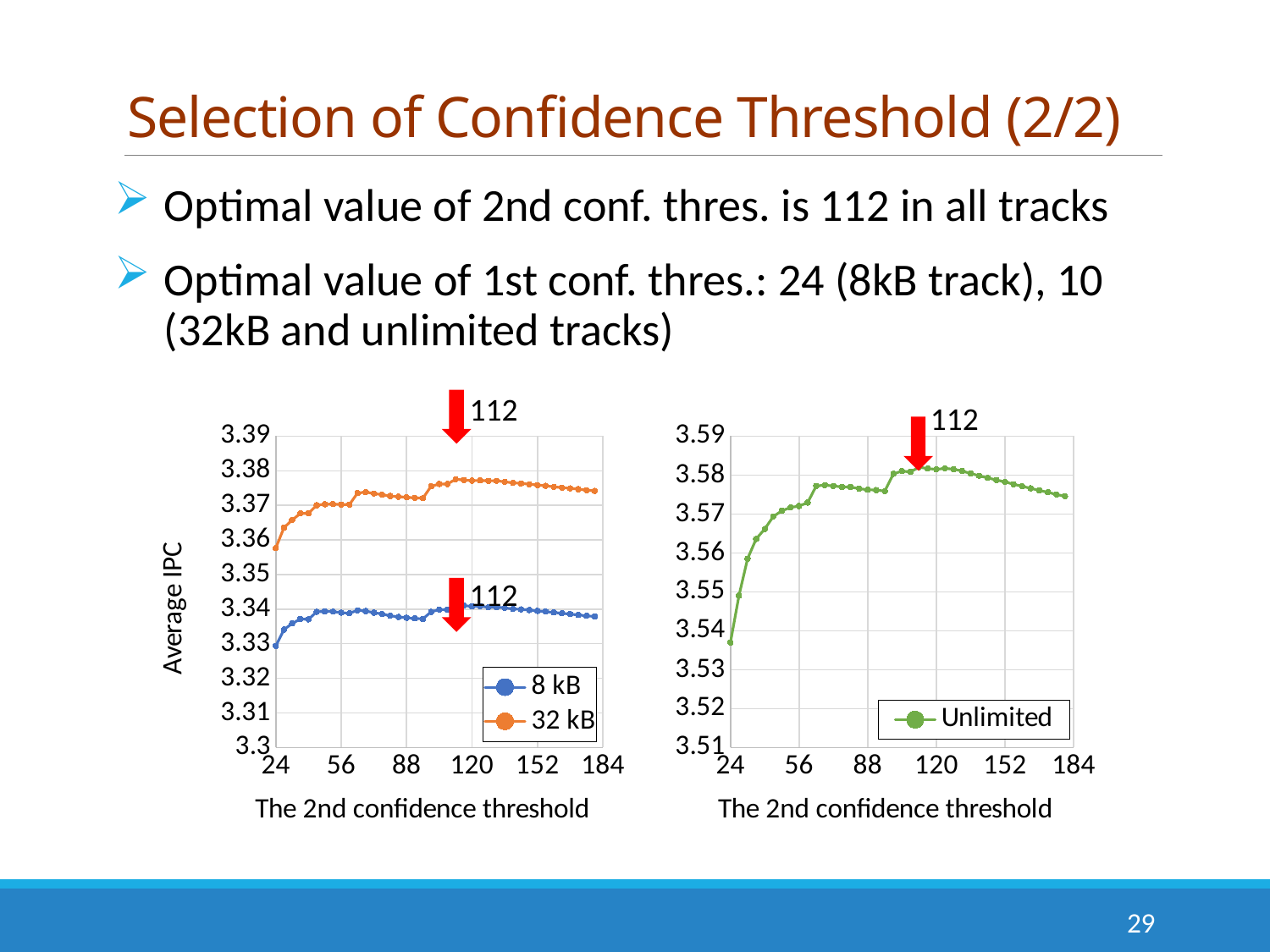
In the left chart, which series has higher Average IPC values, 8 kB or 32 kB? 32 kB In the right chart, does the Unlimited series rise or fall between a 2nd confidence threshold of 120 and 184? fall In the right chart, does the Unlimited series rise or fall between a 2nd confidence threshold of 24 and 112? rise How many series does the legend of the left chart list? 2 What is the x-axis title of the right chart? The 2nd confidence threshold What kind of chart is the left chart on the slide? line chart How many series does the legend of the right chart list? 1 What is the y-axis title of the left chart? Average IPC In the left chart, is the value for 8 kB at a 2nd confidence threshold of 112 greater or less than 3.35? less In the right chart, is the value for Unlimited at a 2nd confidence threshold of 24 greater or less than 3.55? less In the left chart, is the value for 32 kB at a 2nd confidence threshold of 112 greater or less than 3.37? greater